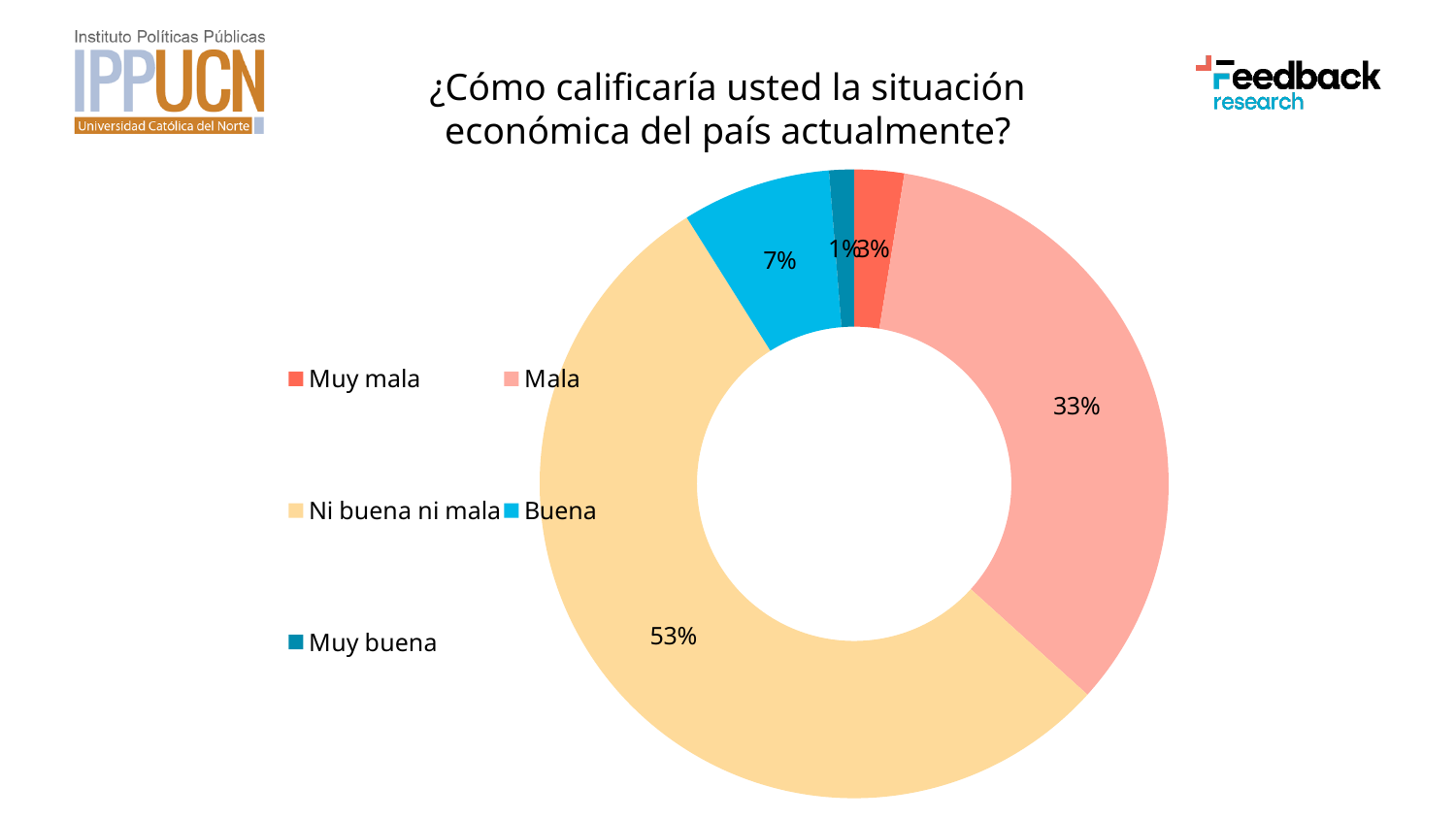
What percentage of respondents rated the economic situation as "Ni buena ni mala"? 53% What percentage of respondents rated the economic situation as "Muy mala"? 3% How many categories does the chart show? 5 What kind of chart is shown on the slide? Doughnut chart What colour is used for the "Ni buena ni mala" category? Light yellow What is the combined share of "Muy mala" and "Mala"? 36% What is the difference in percentage points between "Ni buena ni mala" and "Mala"? 20 What percentage of respondents rated the economic situation as "Buena"? 7% Which category has the largest share of the chart? Ni buena ni mala Which is larger, the share for "Mala" or the share for "Buena"? Mala What percentage of respondents rated the economic situation as "Mala"? 33% Which category has the smallest share of the chart? Muy buena